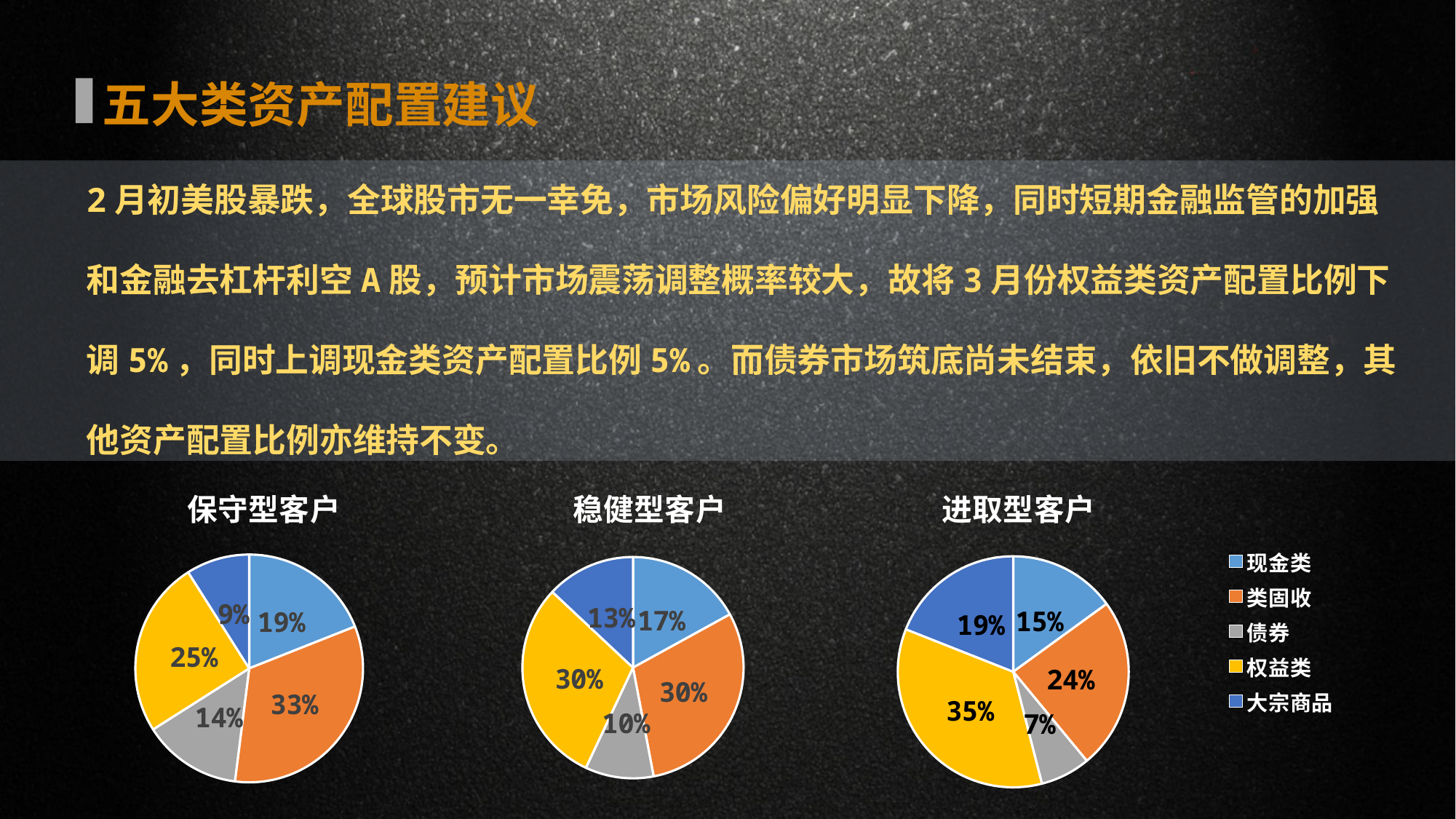
In the 保守型客户 pie chart, which category has the largest share? 类固收 In the 进取型客户 pie chart, which category has the smallest share? 债券 In the 稳健型客户 pie chart, what share does 债券 have? 10% In the 稳健型客户 pie chart, which category has the smallest share? 债券 In the 进取型客户 pie chart, what is the difference between the 权益类 share and the 类固收 share? 11% What kind of chart is used for 稳健型客户? Pie chart In the 进取型客户 pie chart, what share does 权益类 have? 35% In the 保守型客户 pie chart, which is larger, the share of 现金类 or the share of 大宗商品? 现金类 Which colour represents 权益类 in the pie charts? Yellow How many categories does the legend list for the pie charts? 5 How many pie charts are shown on the slide? 3 In the 保守型客户 pie chart, what share does 类固收 have? 33%